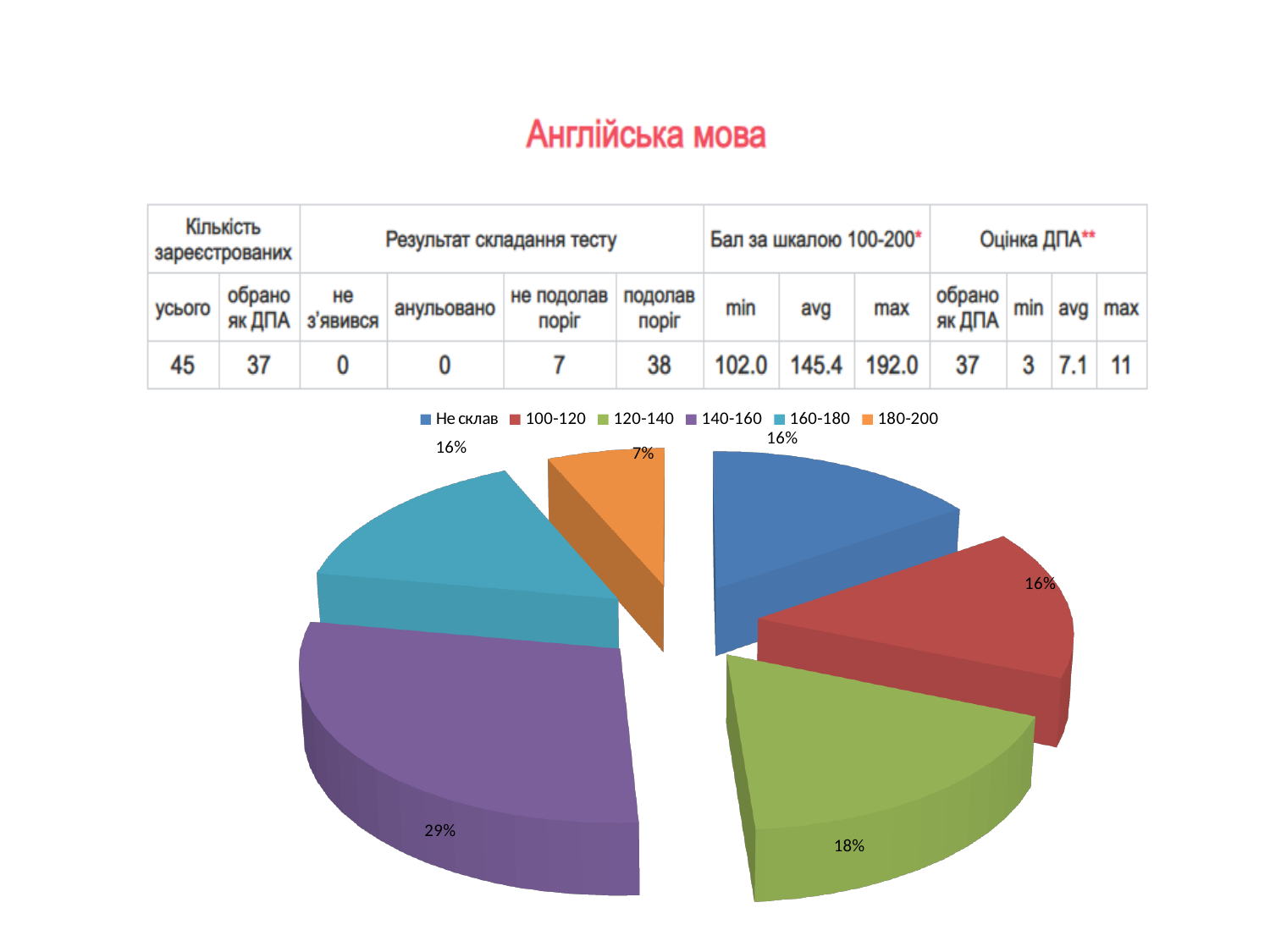
Which category has the largest slice in the pie chart? 140-160 What share of the pie does the 180-200 slice represent? 7% What colour is the 140-160 slice in the pie chart? purple How many slices does the pie chart have? 6 What share of the pie does the 'Не склав' slice represent? 16% What share of the pie does the 140-160 slice represent? 29% Which category has the smallest slice in the pie chart? 180-200 What kind of chart is shown on the slide? pie chart Which slice is larger, 120-140 or 180-200? 120-140 How many entries does the legend of the pie chart list? 6 What is the difference in percentage points between the 140-160 slice and the 120-140 slice? 11